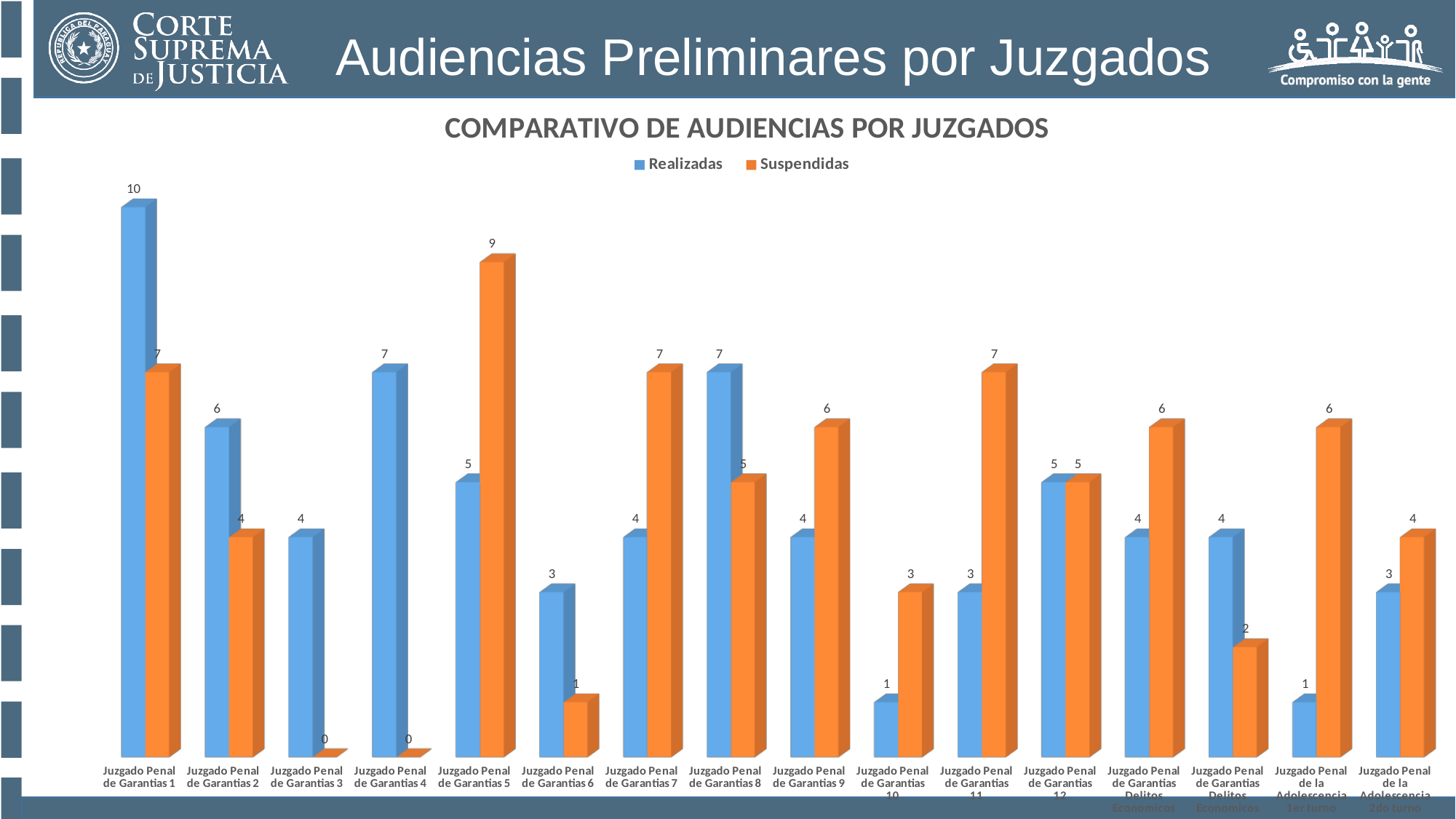
Which juzgado has the highest Realizadas value? Juzgado Penal de Garantias 1 What is the Suspendidas value for Juzgado Penal de Garantias 5? 9 What is the Suspendidas value for Juzgado Penal de Garantias 3? 0 What is the difference between Realizadas and Suspendidas for Juzgado Penal de Garantias 1? 3 What is the Realizadas value for Juzgado Penal de Garantias 10? 1 What is the title of the chart? COMPARATIVO DE AUDIENCIAS POR JUZGADOS Which juzgado has the highest Suspendidas value? Juzgado Penal de Garantias 5 For Juzgado Penal de Garantias 7, which is larger, Realizadas or Suspendidas? Suspendidas What type of chart is shown on the slide? bar chart What is the Realizadas value for Juzgado Penal de Garantias 1? 10 For Juzgado Penal de Garantias 8, which is larger, Realizadas or Suspendidas? Realizadas How many series does the legend list? 2